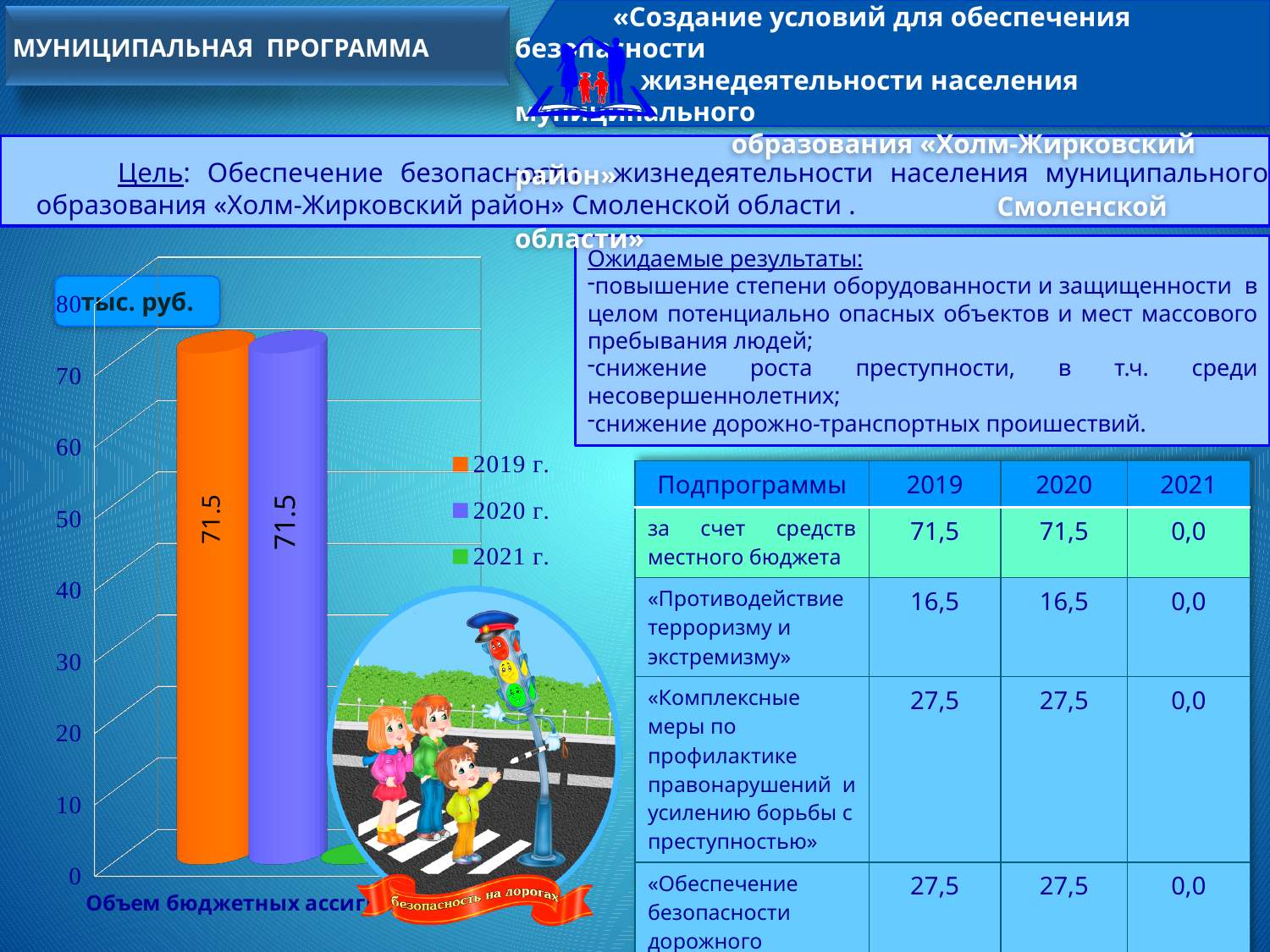
What is the difference between the values for 2019 г. and 2020 г.? 0 How many series does the chart legend list? 3 What is the value shown for 2020 г. in the bar chart? 71.5 What is the highest value shown on the vertical axis of the chart? 80 What unit is indicated in the label at the top of the chart? тыс. руб. Is the value for 2021 г. greater or less than 10? less What is the value shown for 2019 г. in the bar chart? 71.5 Do the values fall or stay the same from 2019 г. to 2020 г.? stay the same What kind of chart is shown on the left of the slide? bar chart Which colour represents 2019 г. in the chart legend? orange Is the value for 2019 г. greater or less than 70? greater Which year has the lowest value in the bar chart? 2021 г.